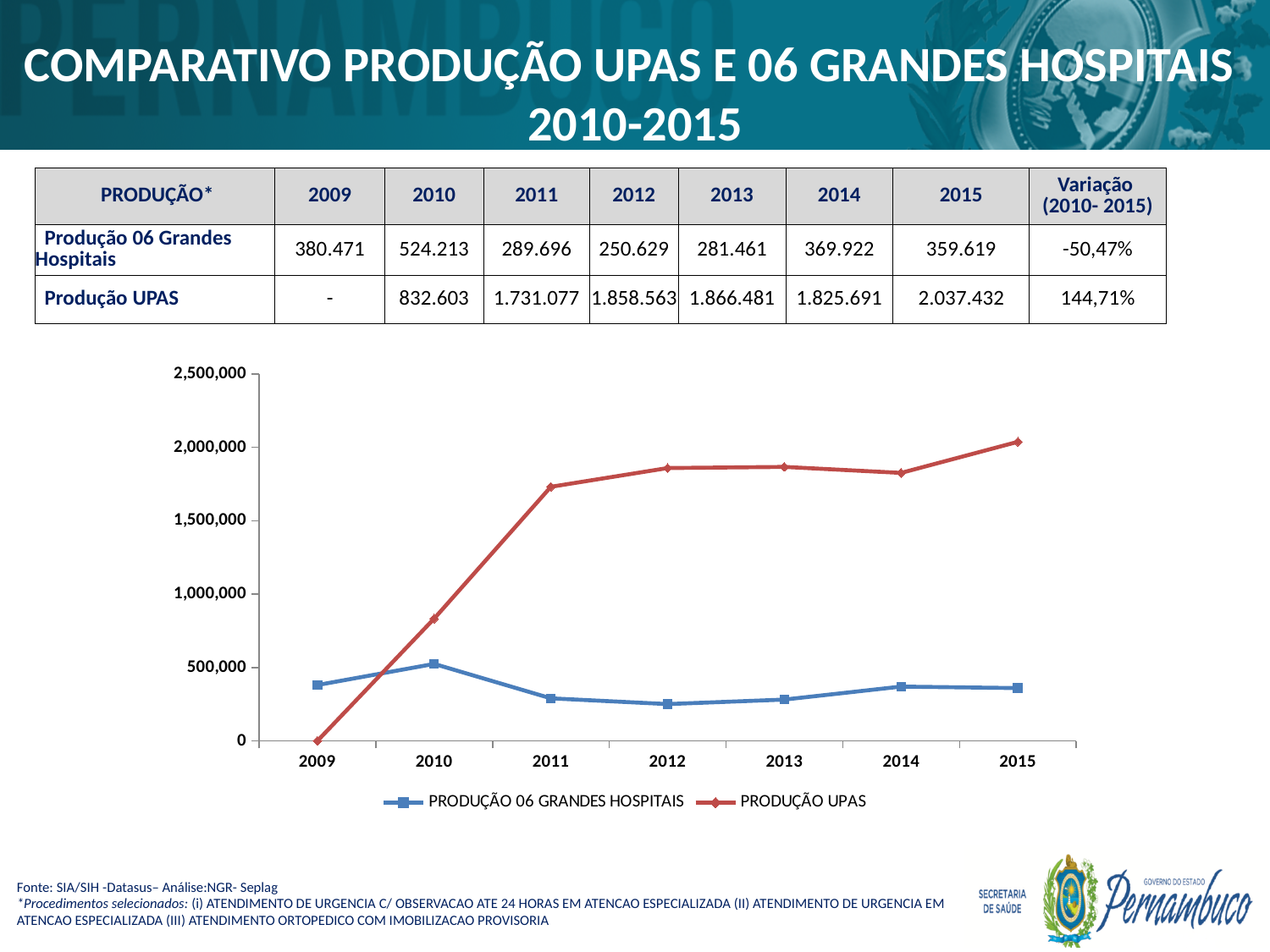
In which year is PRODUÇÃO UPAS highest? 2015 How many years are plotted along the x axis of the chart? 7 In which year is PRODUÇÃO 06 GRANDES HOSPITAIS lowest? 2012 In 2013, which series has the larger value, PRODUÇÃO UPAS or PRODUÇÃO 06 GRANDES HOSPITAIS? PRODUÇÃO UPAS How many series does the chart legend list? 2 What is the difference between PRODUÇÃO UPAS in 2015 and in 2014? 211.741 Is the value for PRODUÇÃO 06 GRANDES HOSPITAIS in 2014 greater or less than 500,000? less Does the PRODUÇÃO UPAS line rise or fall from 2010 to 2015? rise What kind of chart is shown on the slide? line chart What is the value of Produção 06 Grandes Hospitais in 2010? 524.213 Is the value for PRODUÇÃO UPAS in 2011 greater or less than 1,500,000? greater What is the value of PRODUÇÃO UPAS in 2015? 2.037.432